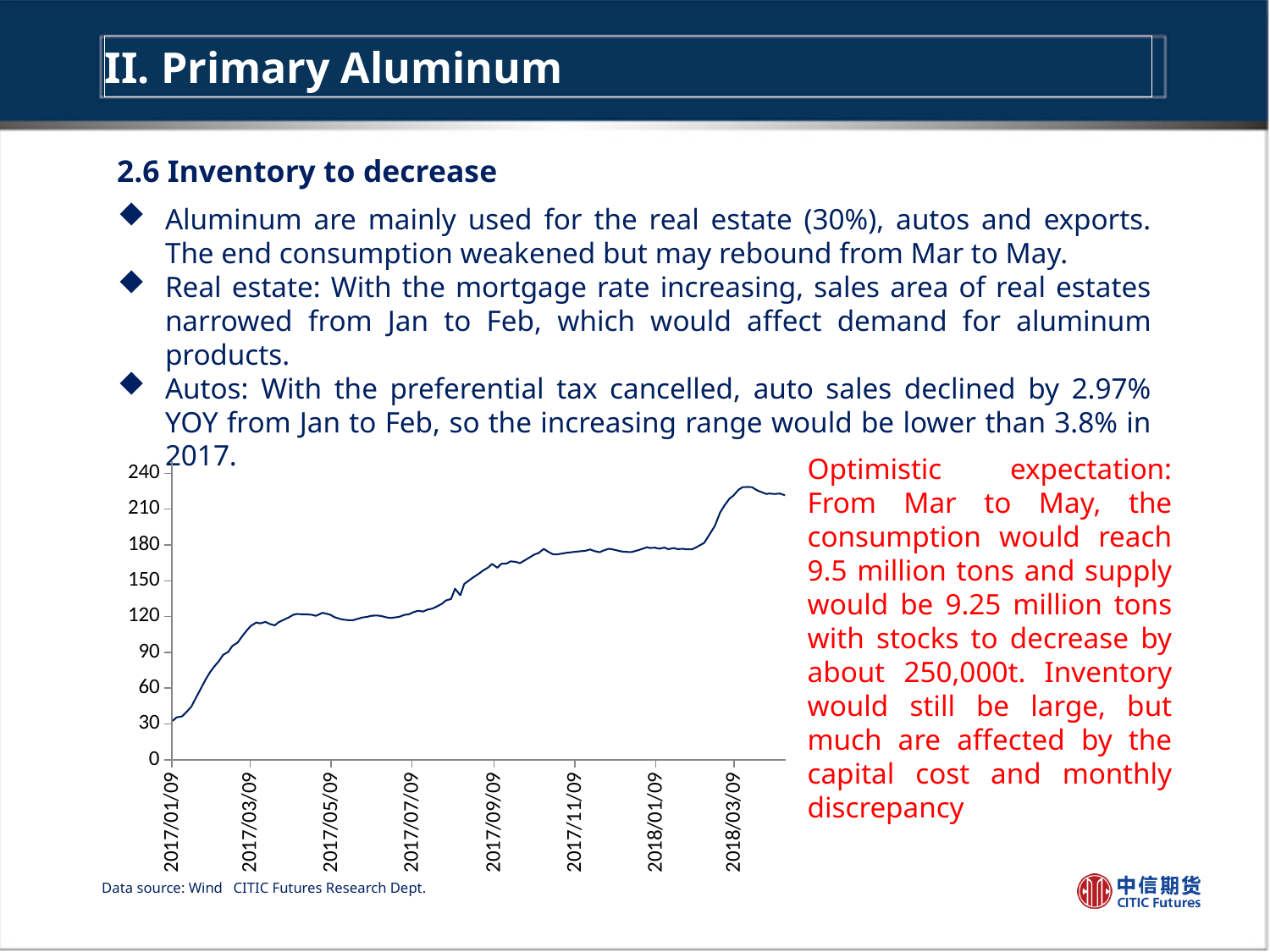
Overall, does the plotted value rise or fall from 2017/01/09 to 2018/03/09? rise Is the value at 2018/03/09 greater or less than 210? greater Is the value at 2017/03/09 greater or less than 150? less How many date labels are shown on the x axis? 8 At which labelled x-axis date is the plotted value lowest? 2017/01/09 Is the value at 2017/01/09 greater or less than 60? less At which labelled x-axis date is the plotted value highest? 2018/03/09 What kind of chart is shown on the slide? line chart Which is larger, the value at 2017/05/09 or the value at 2017/09/09? 2017/09/09 How many lines are plotted on the chart? 1